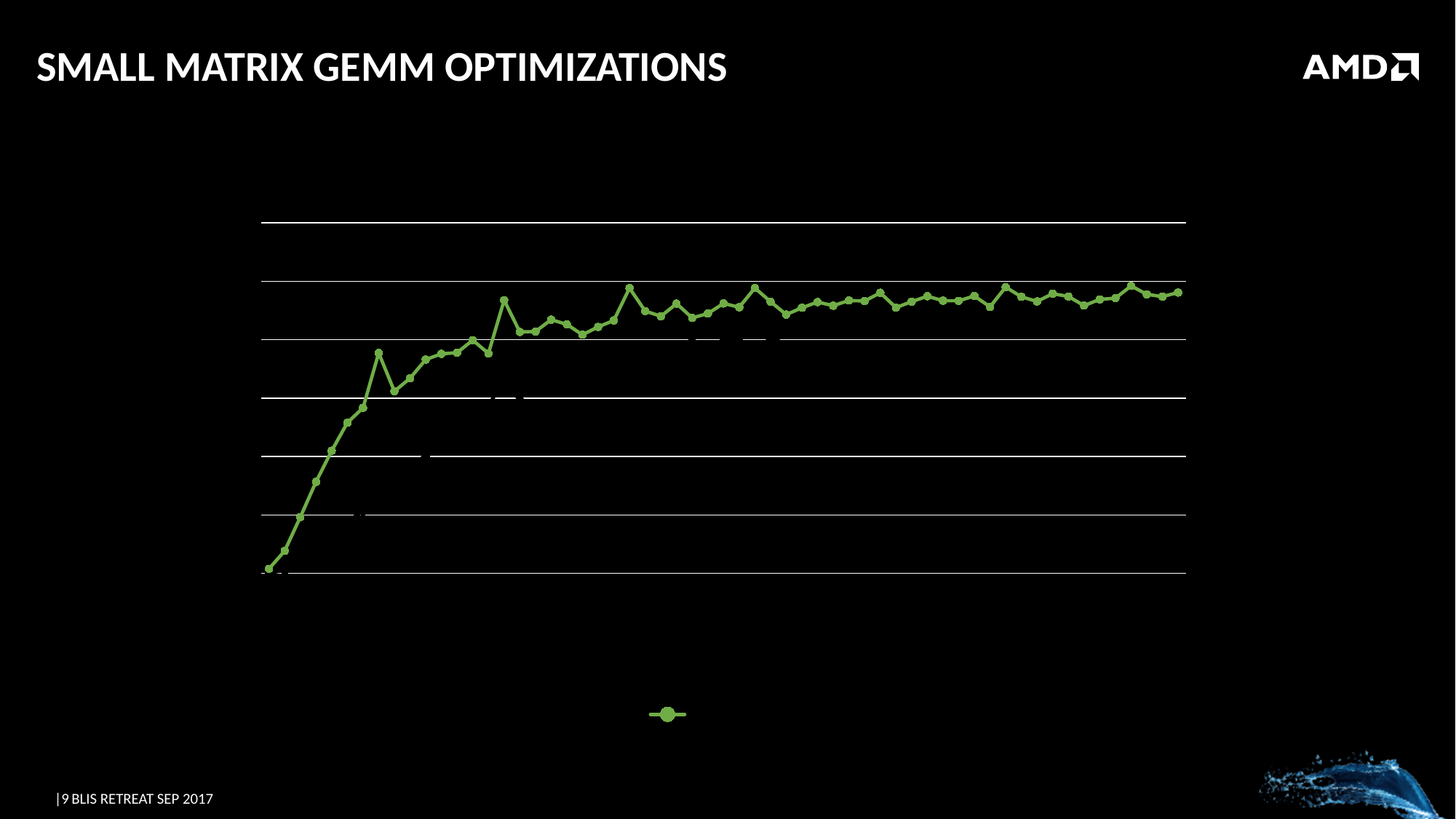
What is the title of the slide containing the chart? SMALL MATRIX GEMM OPTIMIZATIONS Do the values of the line generally rise or fall moving from left to right along the x axis? rise What colour is the plotted line in the chart? green Is the lowest point of the line at the left end or the right end of the x axis? left end What kind of chart is shown on the slide? line chart